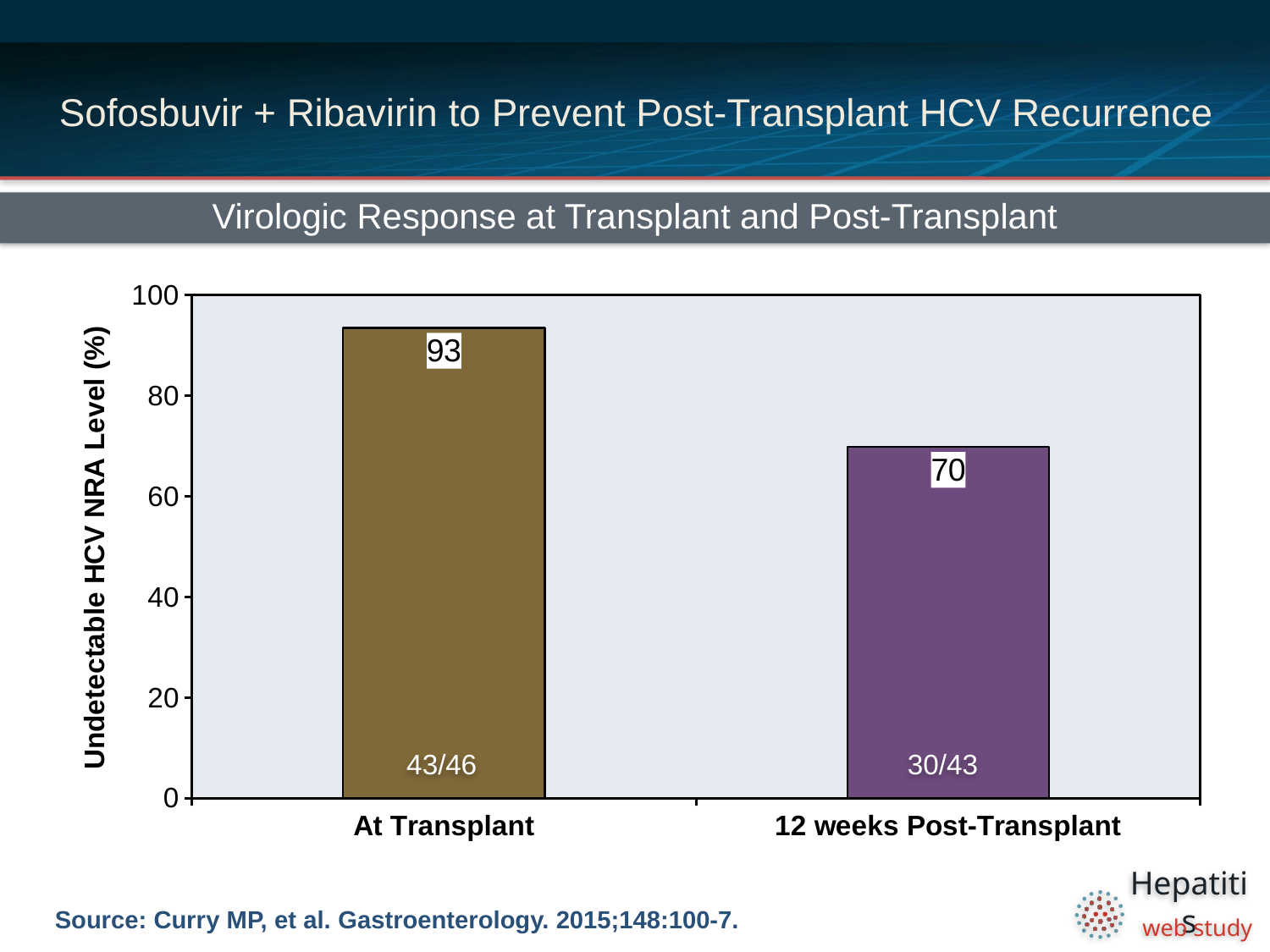
What is the value for 12 weeks Post-Transplant? 70 Which category has the lowest value? 12 weeks Post-Transplant Which is larger, the value for At Transplant or for 12 weeks Post-Transplant? At Transplant What is the difference between the values for At Transplant and 12 weeks Post-Transplant? 23 Do the values rise or fall from At Transplant to 12 weeks Post-Transplant? fall What is the y-axis label of the chart? Undetectable HCV NRA Level (%) How many categories are shown on the x axis? 2 Is the value for 12 weeks Post-Transplant greater or less than 80? less What kind of chart is shown? bar chart What is the value for At Transplant? 93 Which category has the highest value? At Transplant What fraction is printed inside the At Transplant bar? 43/46